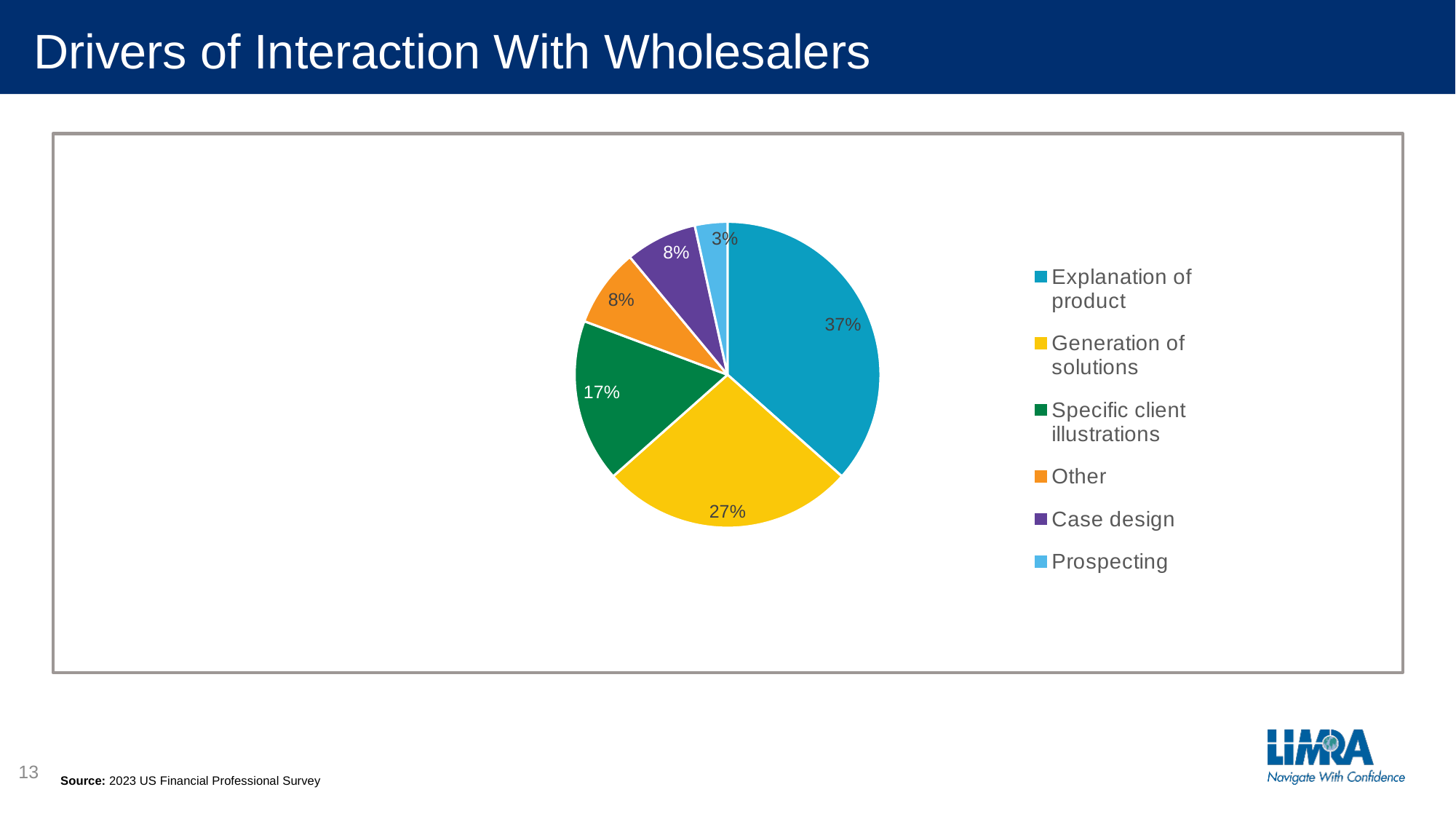
What share of the pie is Case design? 8% What share of the pie is Specific client illustrations? 17% Which category has the smallest slice of the pie? Prospecting How many categories does the legend list? 6 Which is larger, Specific client illustrations or Other? Specific client illustrations What share of the pie is Explanation of product? 37% What share of the pie is Generation of solutions? 27% What is the difference in percentage points between Explanation of product and Generation of solutions? 10 What is the title of the slide containing the chart? Drivers of Interaction With Wholesalers What kind of chart is shown on the slide? Pie chart What share of the pie is Prospecting? 3% Which category has the largest slice of the pie? Explanation of product